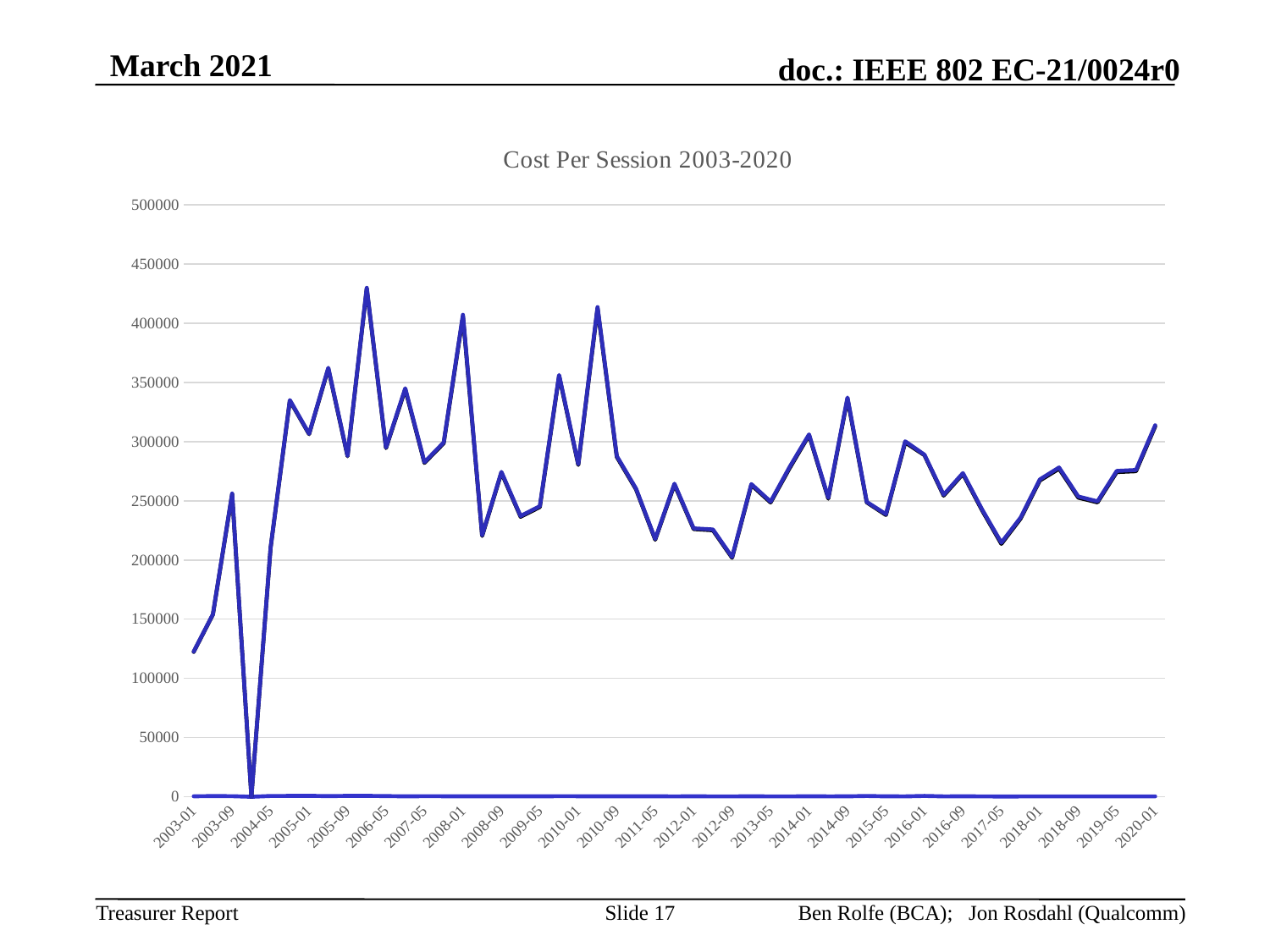
Which has the higher cost per session, 2005-01 or 2017-05? 2005-01 What is the highest value shown on the y axis? 500000 What kind of chart is shown on the slide? line chart What is the title of the chart? Cost Per Session 2003-2020 Is the cost per session for 2008-01 greater or less than 350000? greater Is the cost per session for 2014-09 greater or less than 300000? greater Is the cost per session for 2017-05 greater or less than 250000? less Which has the higher cost per session, 2003-01 or 2020-01? 2020-01 Between 2003-01 and 2003-09, does the cost per session rise or fall? rise